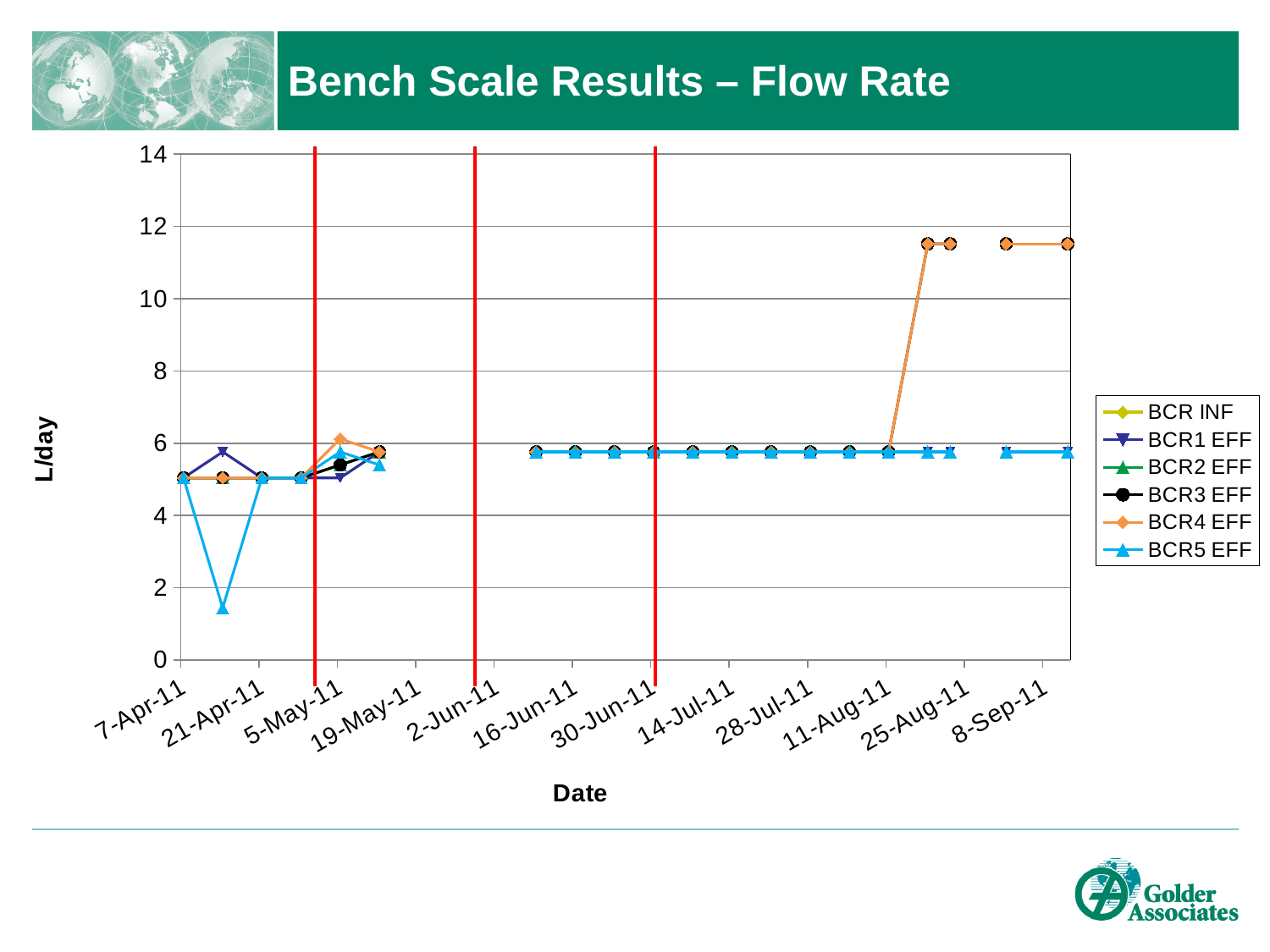
Which series has the lowest point on the chart? BCR5 EFF Is the value for BCR1 EFF at 21-Apr-11 greater or less than 4? greater What is the title of the chart? Bench Scale Results – Flow Rate At 21-Apr-11, which is larger: BCR1 EFF or BCR5 EFF? Neither; they are equal How many series does the legend list? 6 Is the value for BCR4 EFF at 8-Sep-11 greater or less than 10? greater Is the value for BCR3 EFF at 16-Jun-11 greater or less than 4? greater At 8-Sep-11, which is larger: BCR4 EFF or BCR5 EFF? BCR4 EFF What kind of chart is shown on the slide? Line chart Which series reaches the highest value on the chart? BCR3 EFF and BCR4 EFF (tie) What is the label on the vertical axis? L/day